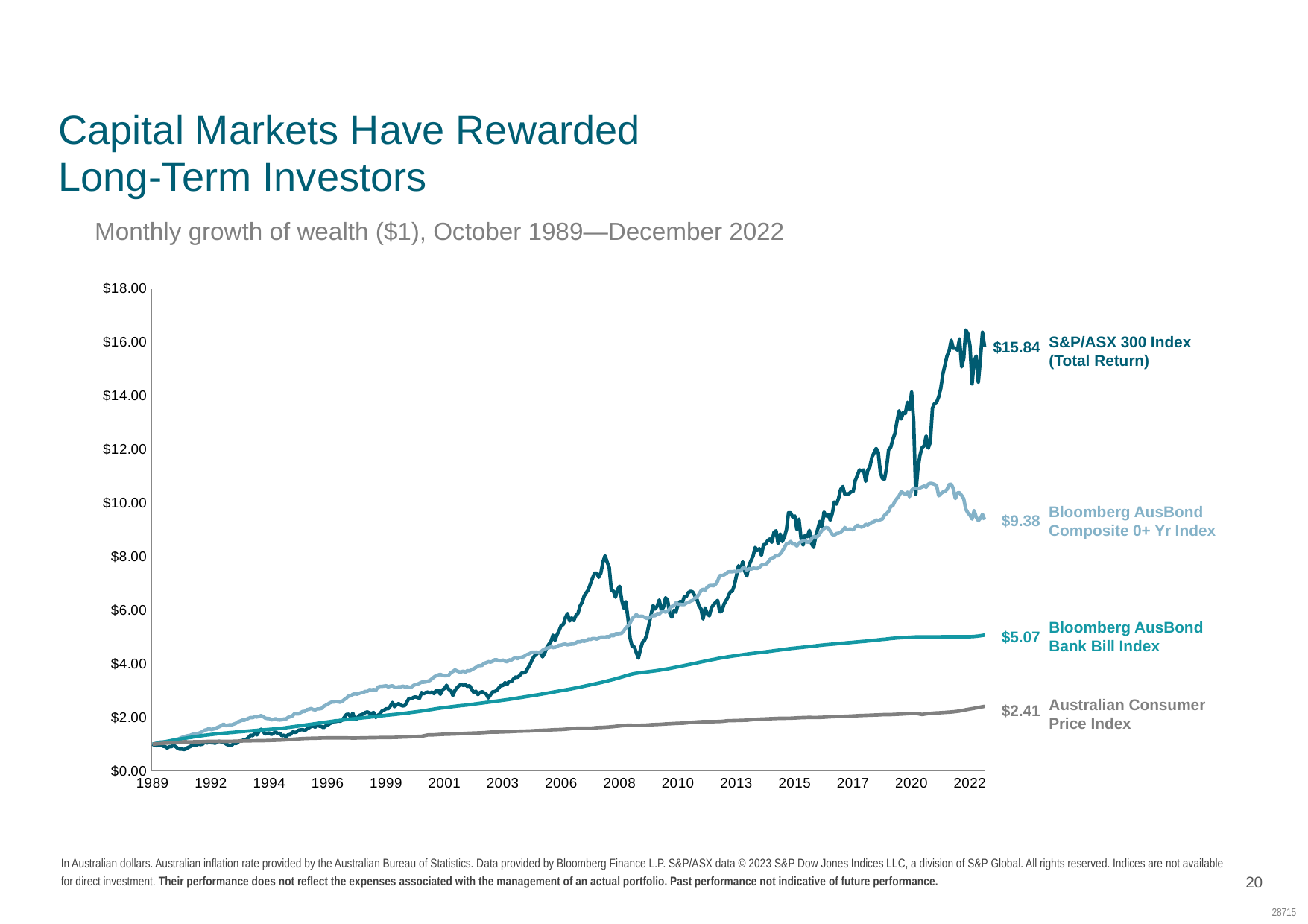
What is the difference between the ending values of the S&P/ASX 300 Index (Total Return) and the Bloomberg AusBond Composite 0+ Yr Index? $6.46 What kind of chart is shown on the slide? Line chart What is the ending value shown for the Bloomberg AusBond Bank Bill Index? $5.07 Which series has the lowest ending value in December 2022? Australian Consumer Price Index What is the ending value shown for the Australian Consumer Price Index? $2.41 How many series are plotted on the chart? 4 Is the value of the Bloomberg AusBond Composite 0+ Yr Index in 2010 greater or less than $4.00? greater What is the ending value shown for the S&P/ASX 300 Index (Total Return)? $15.84 Which has a larger ending value, the Bloomberg AusBond Bank Bill Index or the Australian Consumer Price Index? Bloomberg AusBond Bank Bill Index Does the Australian Consumer Price Index line rise or fall from 1989 to 2022? Rise Which series has the highest ending value in December 2022? S&P/ASX 300 Index (Total Return) What is the ending value shown for the Bloomberg AusBond Composite 0+ Yr Index? $9.38